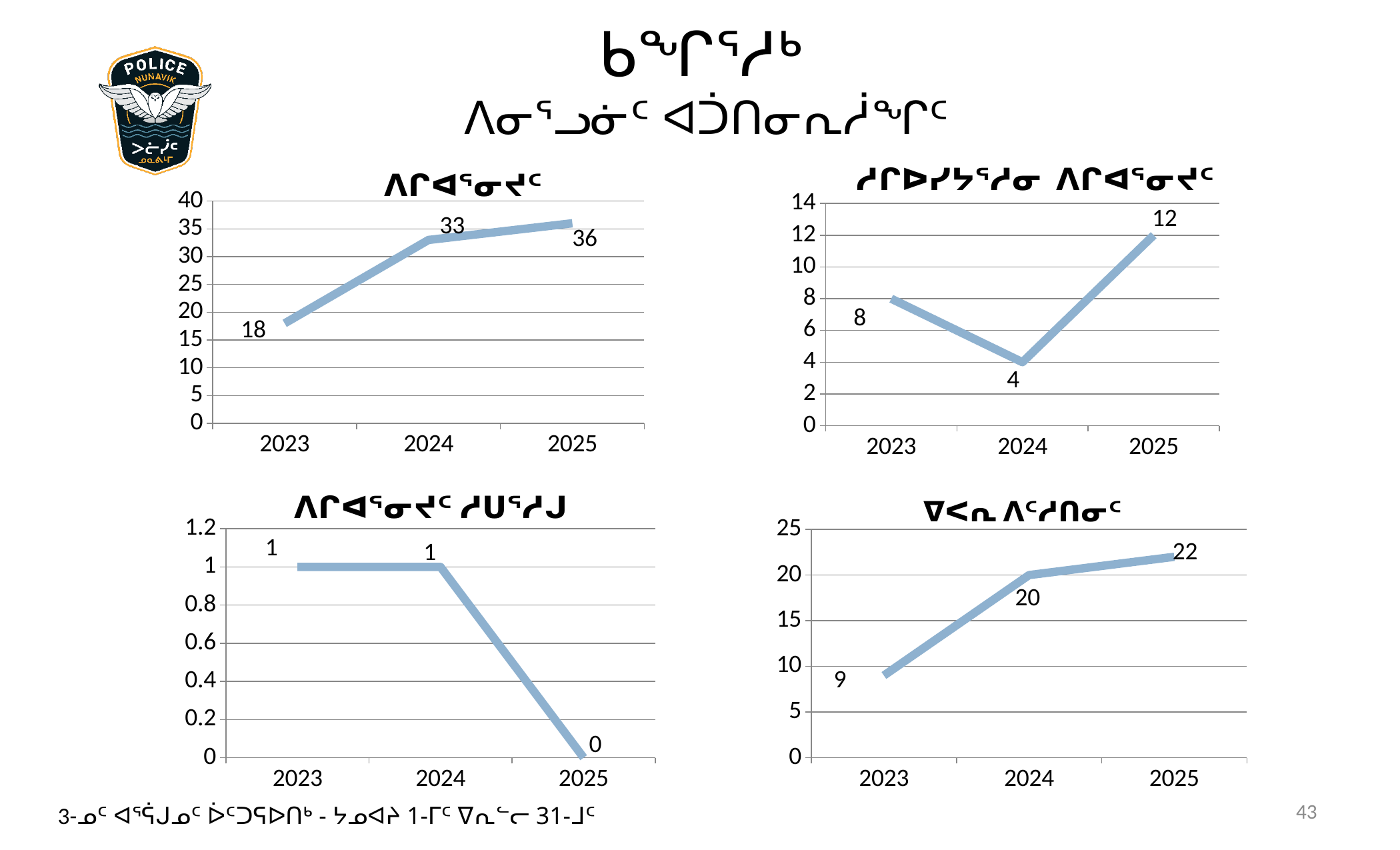
What type of chart is the bottom-right chart? line chart In the bottom-right chart, which year has the highest value? 2025 In the bottom-right chart, what is the value for 2023? 9 In the top-right chart, what is the value for 2025? 12 In the top-right chart, is the value for 2023 larger or smaller than the value for 2025? smaller In the bottom-left chart, what is the value for 2025? 0 In the top-right chart, which year has the lowest value? 2024 In the bottom-right chart, what is the difference between the 2024 and 2023 values? 11 In the top-left chart, what is the difference between the 2025 and 2023 values? 18 In the bottom-left chart, how many data points are plotted? 3 In the top-left chart, what is the value for 2024? 33 In the top-left chart, which year has the lowest value? 2023